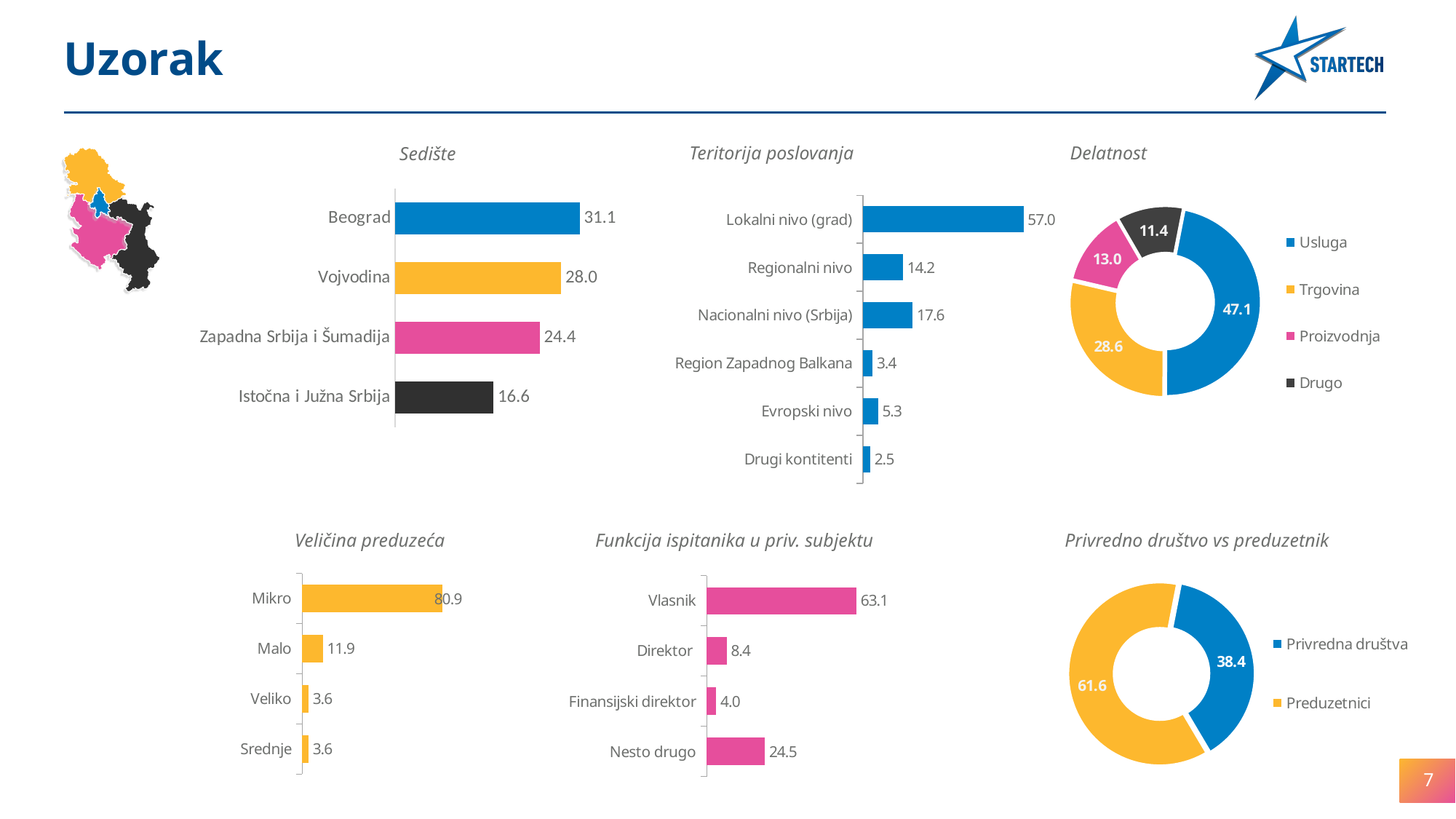
In the 'Veličina preduzeća' chart, what is the difference between Mikro and Malo? 69.0 In the 'Funkcija ispitanika u priv. subjektu' chart, which is larger, Direktor or Nesto drugo? Nesto drugo In the 'Sedište' chart, what is the value for Vojvodina? 28.0 In the 'Privredno društvo vs preduzetnik' chart, what is the value for Preduzetnici? 61.6 In the 'Sedište' chart, which category has the highest value? Beograd In the 'Privredno društvo vs preduzetnik' chart, what kind of chart is it? Doughnut chart In the 'Delatnost' chart, how many entries does the legend list? 4 In the 'Teritorija poslovanja' chart, what is the value for Lokalni nivo (grad)? 57.0 In the 'Teritorija poslovanja' chart, how many categories are shown? 6 In the 'Delatnost' chart, what is the value for Trgovina? 28.6 In the 'Teritorija poslovanja' chart, which category has the lowest value? Drugi kontitenti In the 'Veličina preduzeća' chart, what kind of chart is it? Bar chart